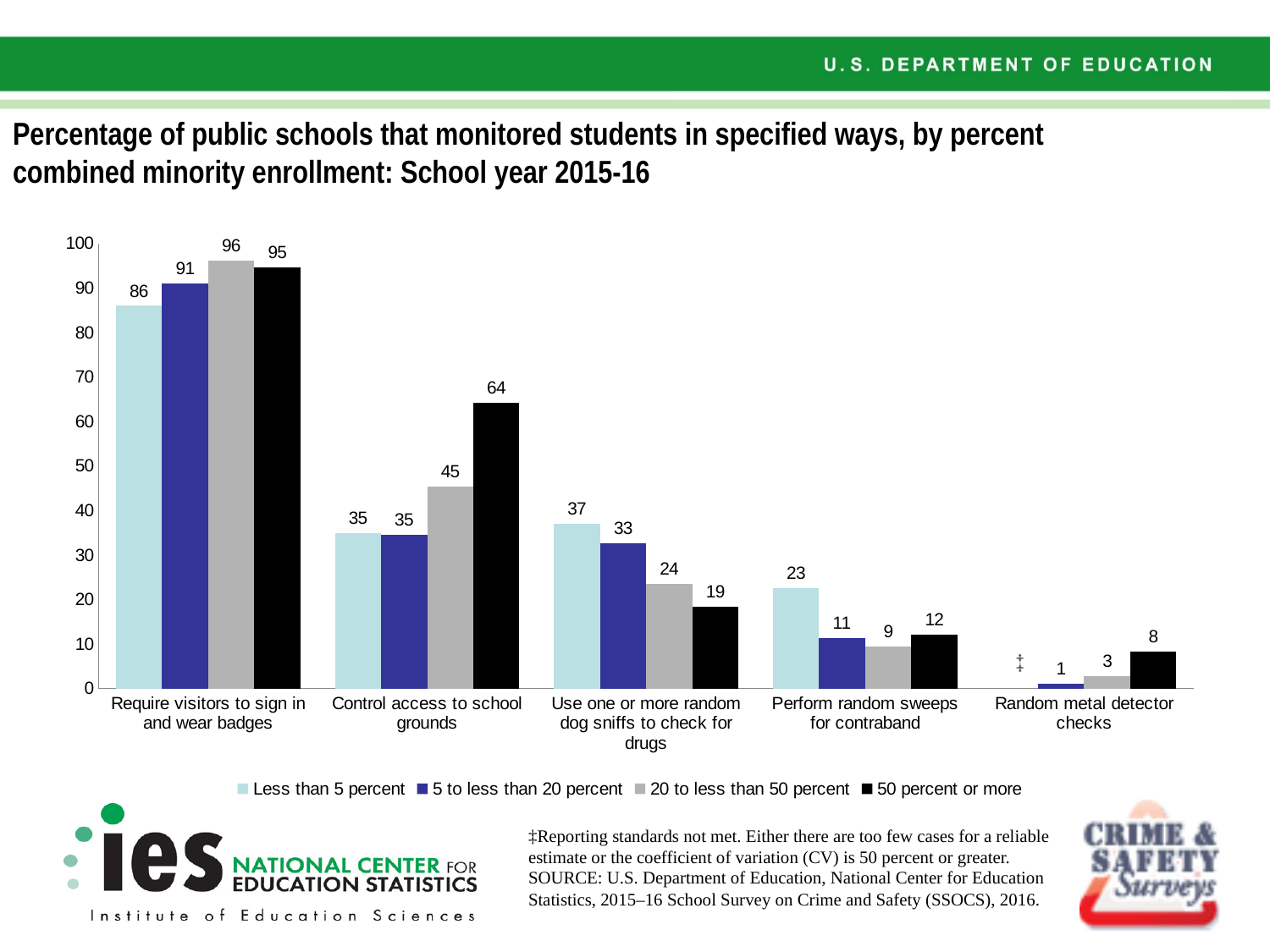
What is the value for '5 to less than 20 percent' schools that use random metal detector checks? 1 Which series is shown in black in the legend? 50 percent or more What percentage of public schools with 50 percent or more combined minority enrollment controlled access to school grounds? 64 Which minority enrollment group has the highest value for 'Use one or more random dog sniffs to check for drugs'? Less than 5 percent Which monitoring practice has the lowest values across all enrollment groups? Random metal detector checks For 'Perform random sweeps for contraband', which is larger: the value for '5 to less than 20 percent' or '50 percent or more'? 50 percent or more What is the value for '20 to less than 50 percent' schools that perform random sweeps for contraband? 9 What is the value for 'Less than 5 percent' schools that require visitors to sign in and wear badges? 86 How many series does the legend list? 4 What is the difference between the '50 percent or more' and 'Less than 5 percent' values for 'Control access to school grounds'? 29 What kind of chart is shown on the slide? Bar chart How many monitoring practices (categories) are shown on the x axis? 5